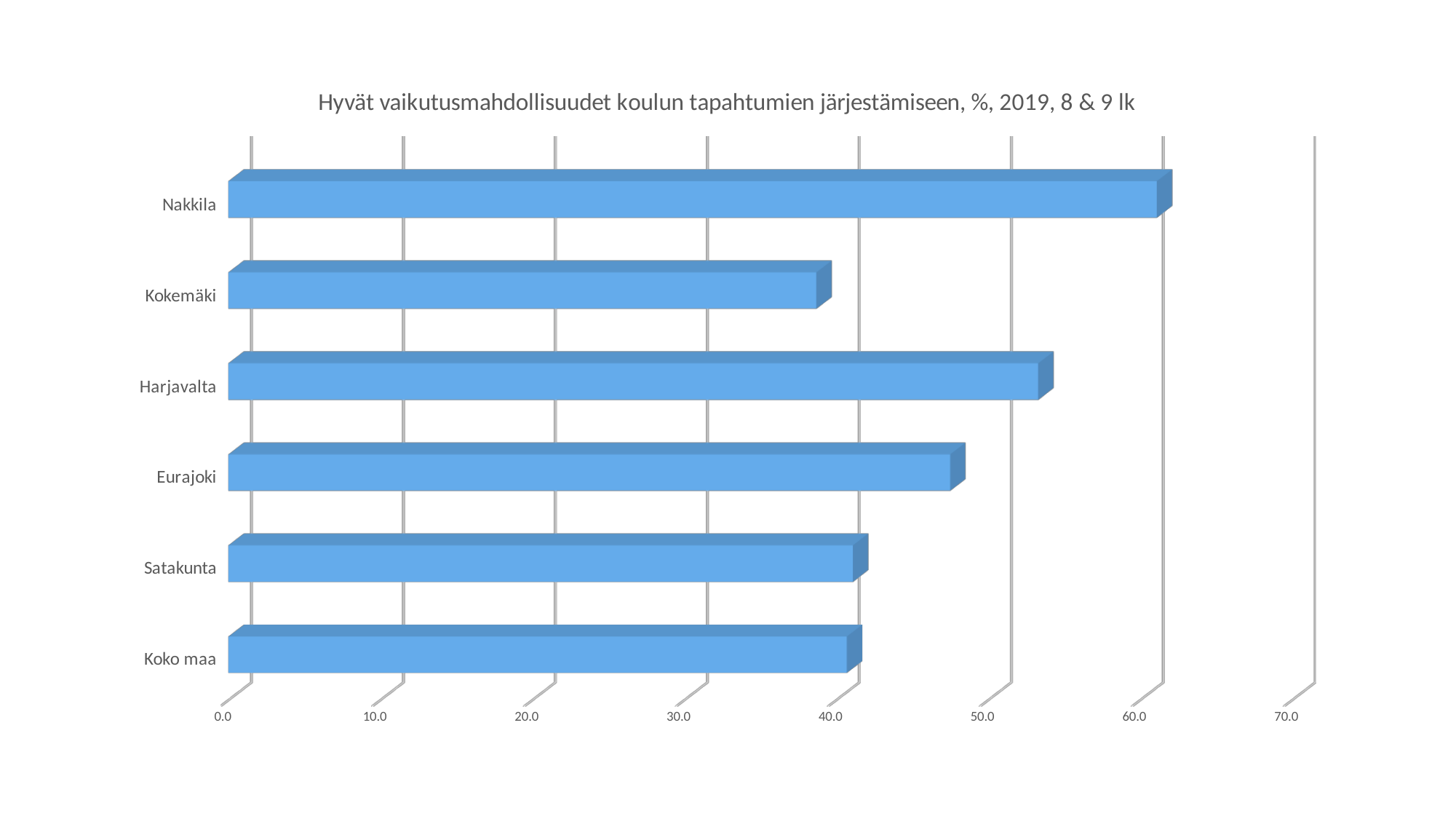
Is the value for Kokemäki greater or less than 30.0? greater Is the value for Nakkila greater or less than 50.0? greater How many categories are shown in the chart? 6 Which category has the lowest value? Kokemäki Is the value for Eurajoki greater or less than 40.0? greater Which has a larger value, Harjavalta or Eurajoki? Harjavalta What kind of chart is shown on the slide? bar chart What is the title of the chart? Hyvät vaikutusmahdollisuudet koulun tapahtumien järjestämiseen, %, 2019, 8 & 9 lk Which has a larger value, Nakkila or Kokemäki? Nakkila Which category has the highest value? Nakkila